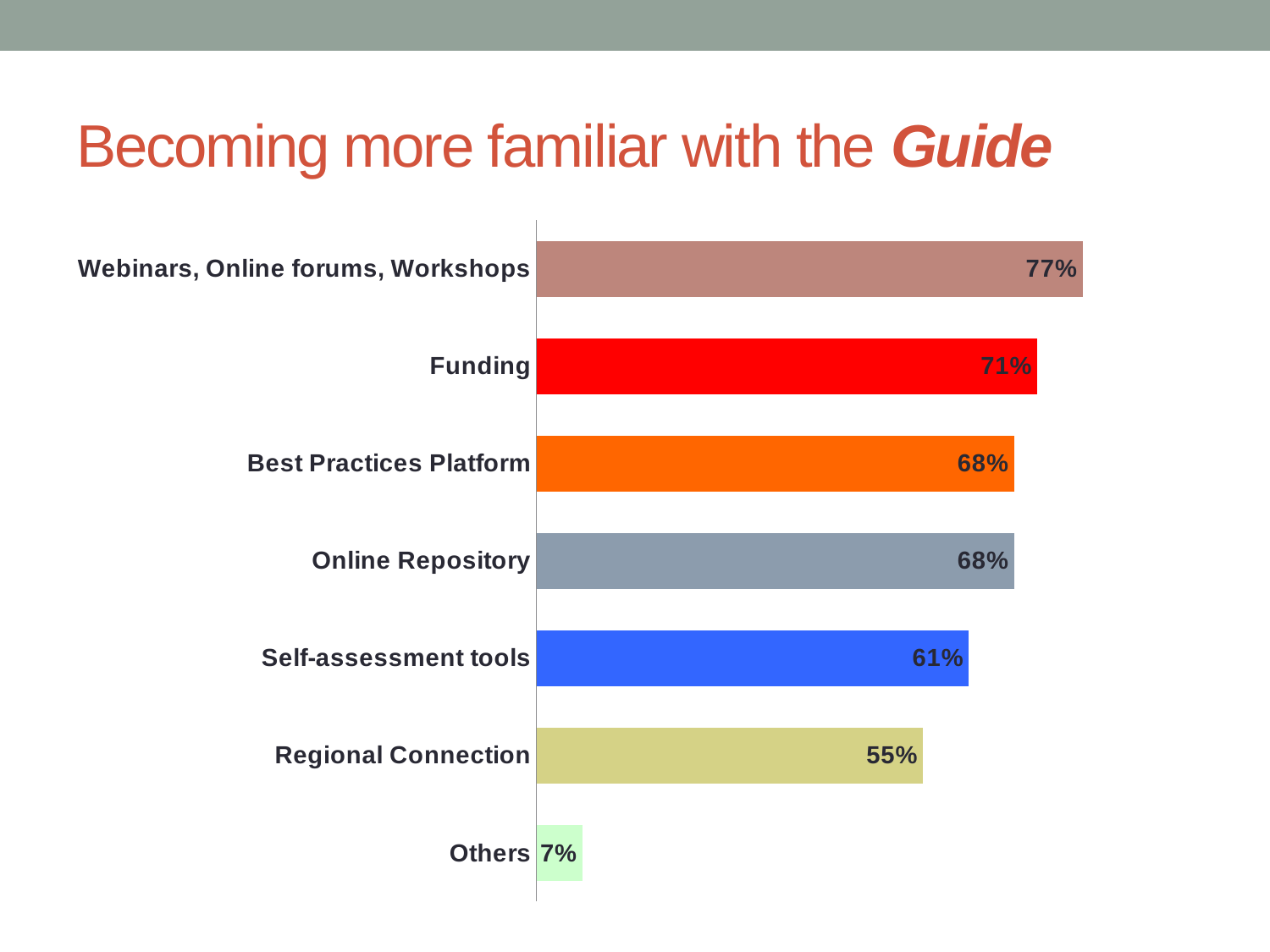
What is the value for Self-assessment tools? 61% What is the value for Others? 7% What is the difference between the values for Webinars, Online forums, Workshops and Funding? 6% What is the value for Funding? 71% What is the value for Regional Connection? 55% What is the title of the slide containing the chart? Becoming more familiar with the Guide How many categories are shown in the chart? 7 What is the difference between the values for Self-assessment tools and Regional Connection? 6% Which category has the lowest value? Others Which category has the highest value? Webinars, Online forums, Workshops What kind of chart is shown on the slide? Bar chart Which is larger, the value for Funding or the value for Online Repository? Funding